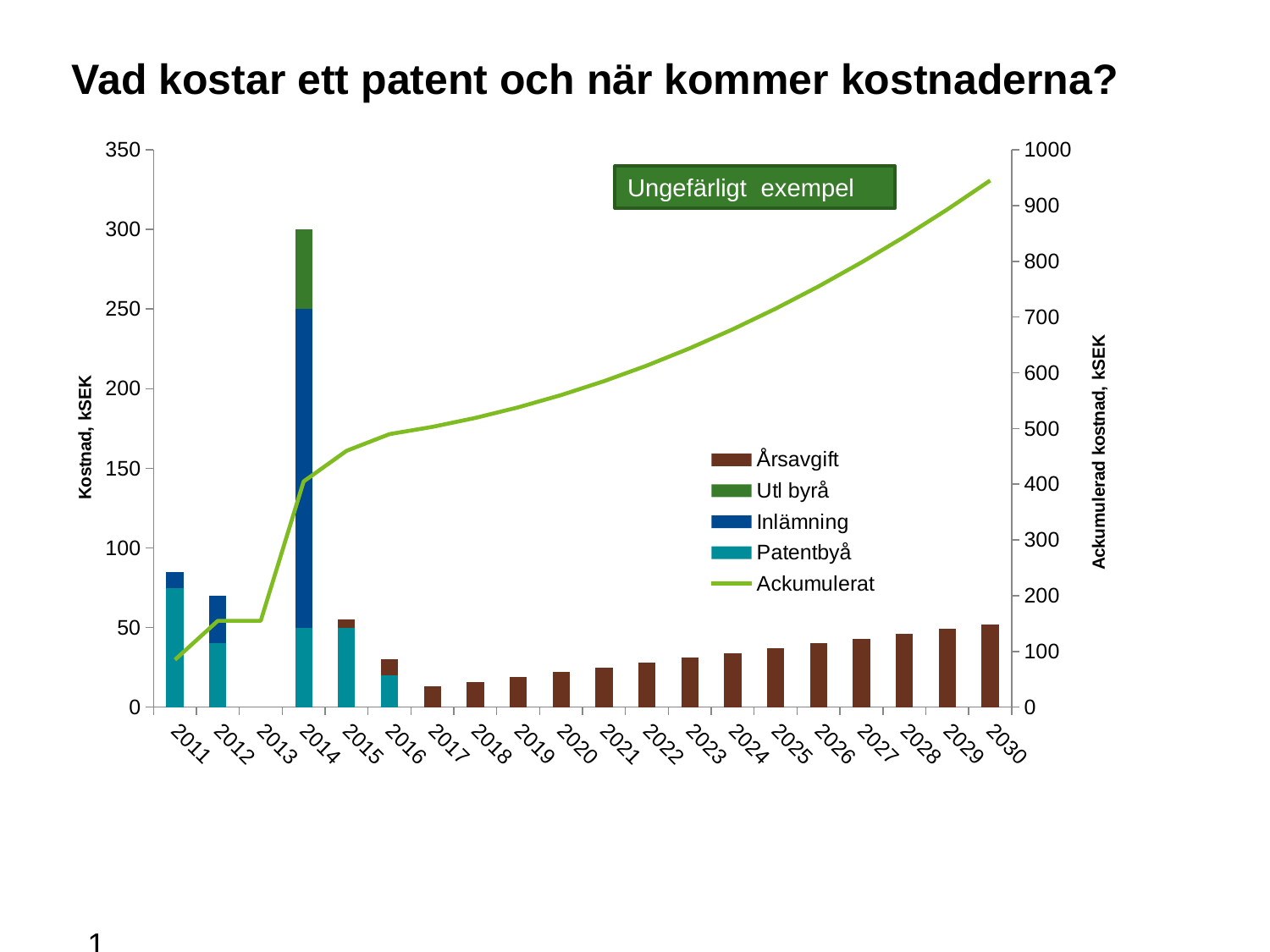
Which year has the shortest bar? 2017 Which year has the tallest stacked bar? 2014 What kind of chart is shown on the slide? A stacked bar chart combined with a line chart Is the bar value for 2017 greater or less than 50? less Do the Årsavgift bars rise or fall from 2017 to 2030? They rise What is the title of the right-hand vertical axis? Ackumulerad kostnad, kSEK Which year has the larger stacked bar, 2011 or 2012? 2011 How many series does the legend list? 5 How many years are shown along the x axis? 20 Is the total bar value for 2014 greater or less than 250? greater Is the Ackumulerat value for 2030 greater or less than 900 on the right axis? greater Does the Ackumulerat line rise or fall from 2011 to 2030? It rises